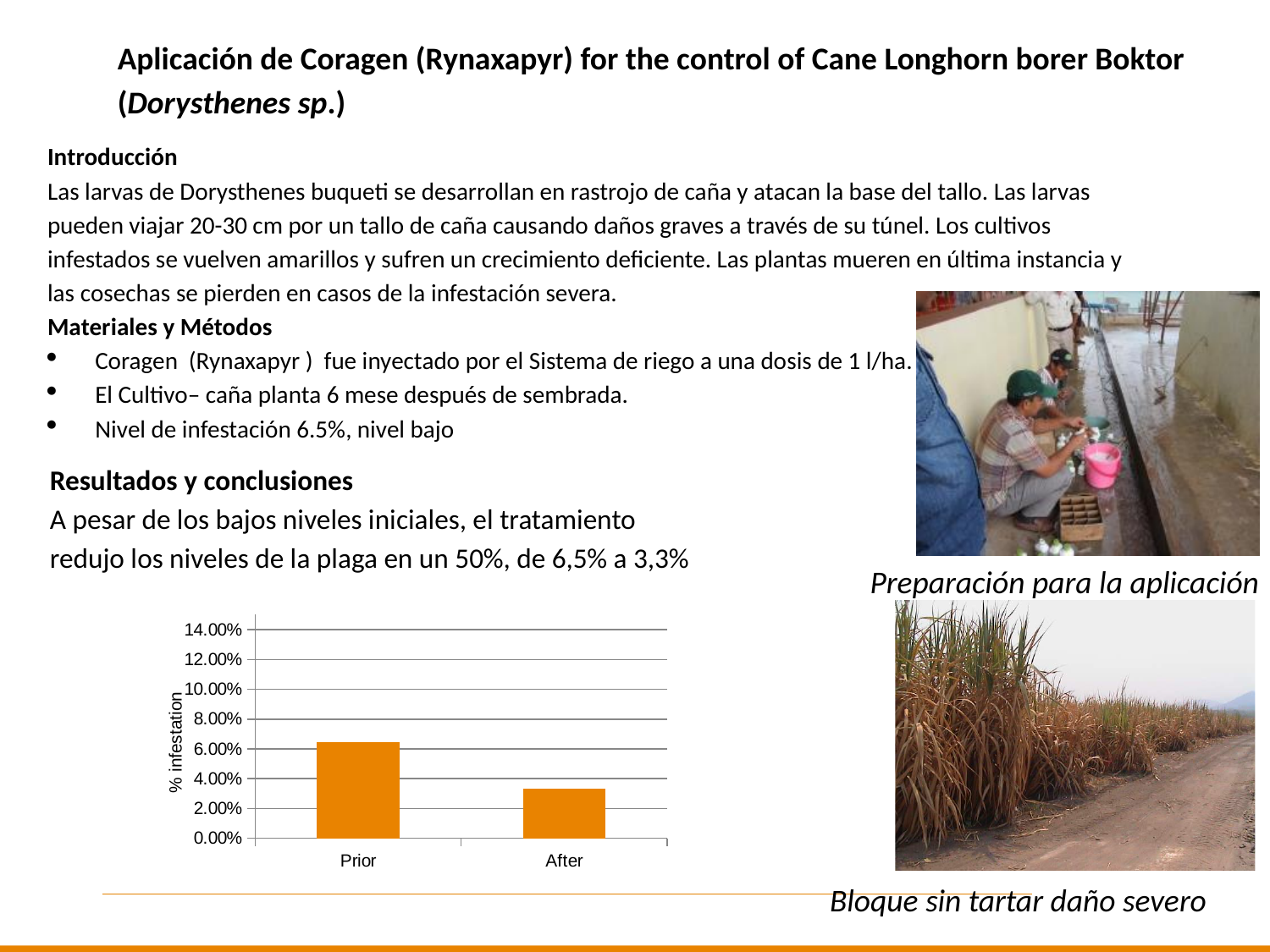
Is the value for After greater or less than 4.00%? less Which is larger in the chart, the value for Prior or the value for After? Prior What kind of chart is shown on the slide? bar chart Is the value for Prior greater or less than 4.00%? greater How many categories are plotted on the x axis of the chart? 2 Is the value for Prior greater or less than 8.00%? less Do the values rise or fall from Prior to After in the chart? fall Which category has the highest % infestation in the chart? Prior Which category has the lowest % infestation in the chart? After What is the label on the vertical axis of the chart? % infestation What is the highest tick value shown on the vertical axis of the chart? 14.00%